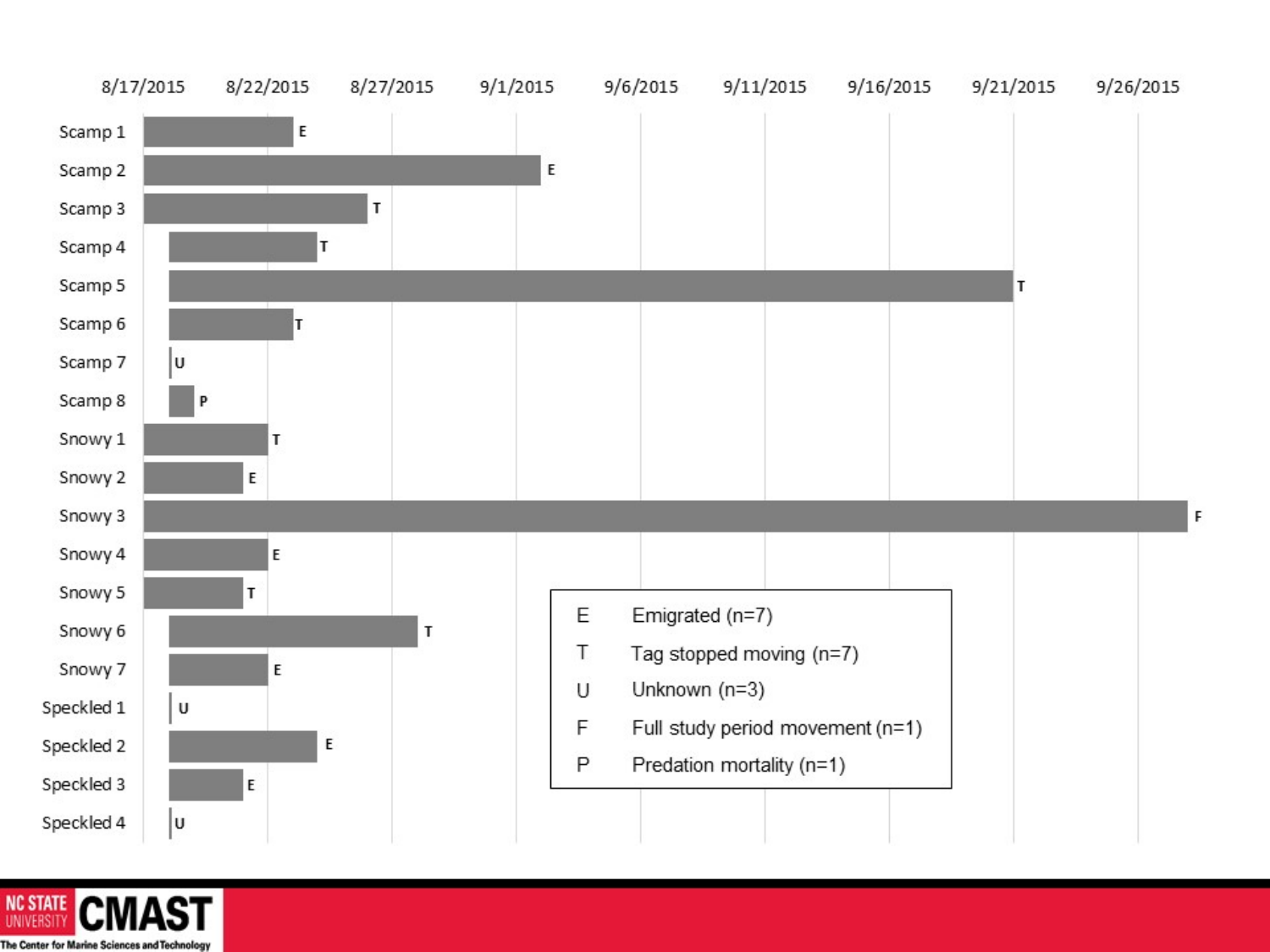
Which bar is longer, Scamp 2 or Scamp 3? Scamp 2 What letter code is shown at the end of the bar for Scamp 5? T How many letter codes does the legend box list? 5 Does the bar for Scamp 5 end before or after 9/16/2015? after What letter code is shown at the end of the bar for Scamp 8? P Among the Speckled fish, which has the longest bar? Speckled 2 Does the bar for Scamp 2 end before or after 9/1/2015? after How many fish (categories) are listed on the vertical axis of the chart? 19 Which fish is the only one marked with the code F (Full study period movement)? Snowy 3 How many fish are marked with the code U (Unknown) in the chart? 3 What kind of chart is shown on the slide? bar chart Which fish has the longest bar in the chart? Snowy 3